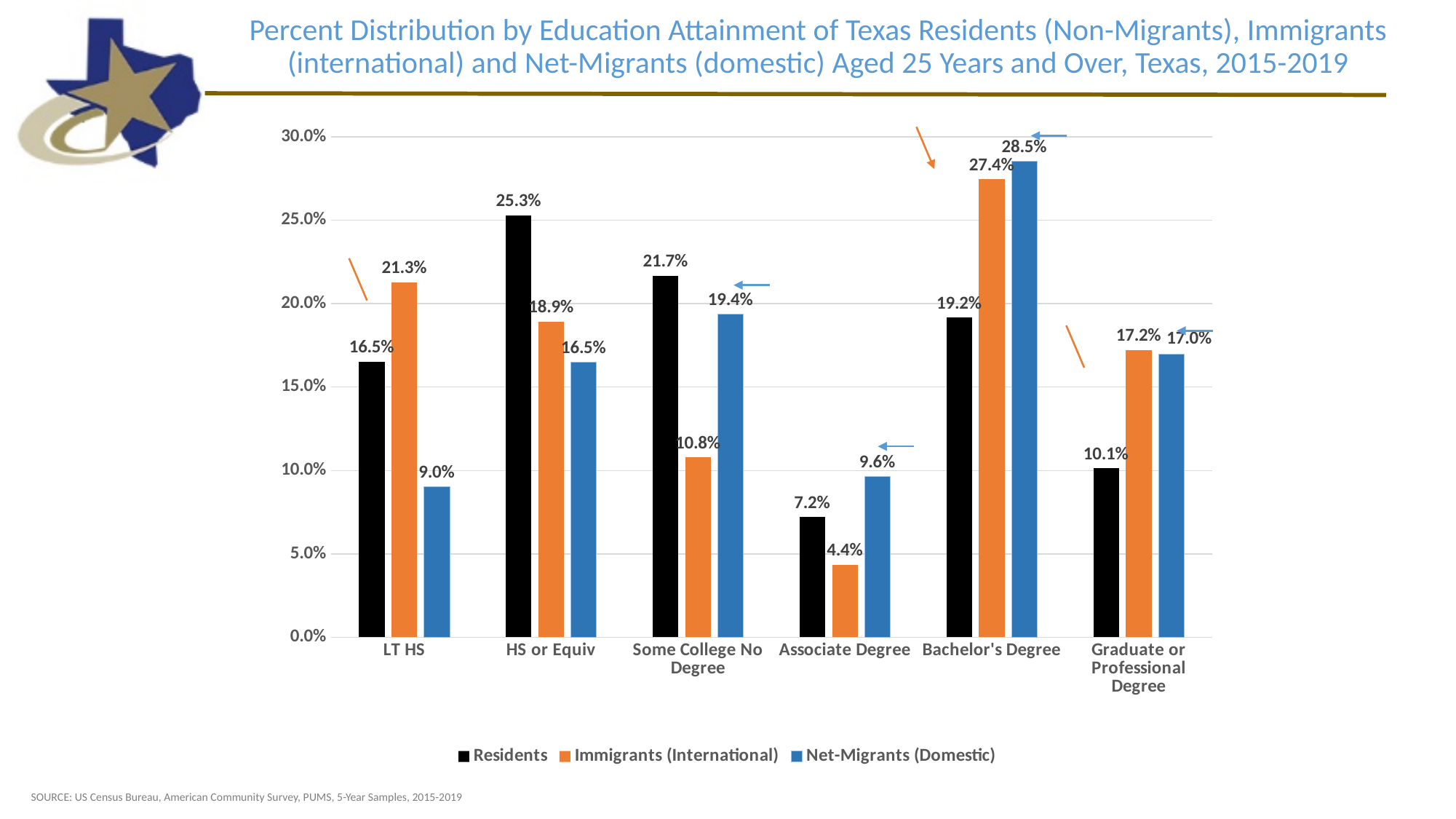
What is the value for Residents in the Associate Degree category? 7.2% What kind of chart is shown on the slide? Bar chart Which education category has the highest value for Residents? HS or Equiv What is the value for Net-Migrants (Domestic) in the Bachelor's Degree category? 28.5% Is the value for Net-Migrants (Domestic) in the HS or Equiv category greater or less than 20.0%? less What colour represents Net-Migrants (Domestic) in the chart? Blue How many series does the legend list? 3 Which is larger in the Graduate or Professional Degree category: Residents or Immigrants (International)? Immigrants (International) Which education category has the lowest value for Immigrants (International)? Associate Degree What is the value for Immigrants (International) in the LT HS category? 21.3% What is the difference between the Residents and Immigrants (International) values in the Some College No Degree category? 10.9% How many education categories are shown on the x axis? 6